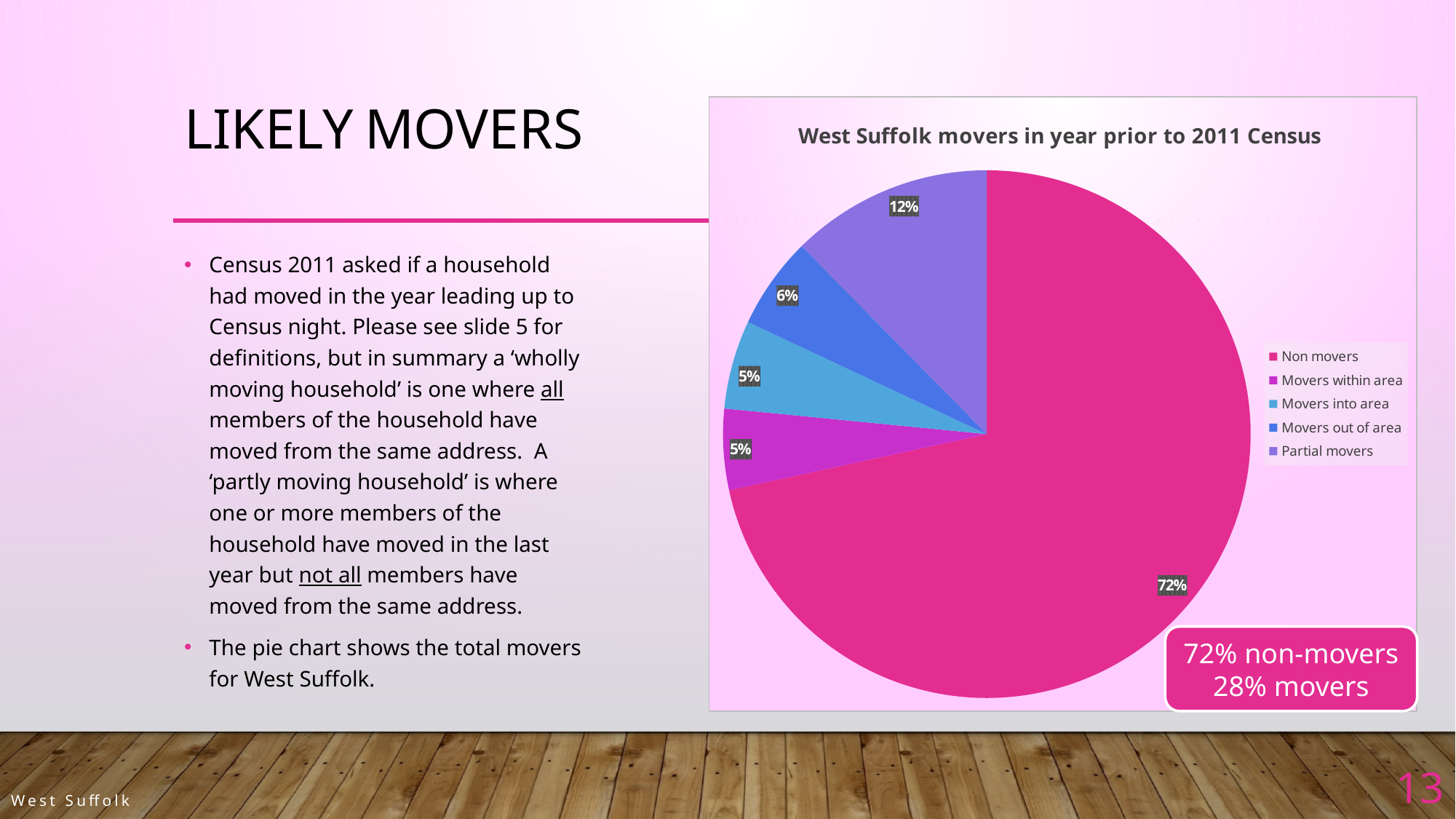
Which is larger, Partial movers or Movers out of area? Partial movers What percentage of the pie is Movers into area? 5% What is the title of the chart? West Suffolk movers in year prior to 2011 Census What percentage of the pie is Partial movers? 12% What percentage of the pie is Movers out of area? 6% What is the difference in percentage points between Non movers and Partial movers? 60 Which category has the largest slice of the pie? Non movers What percentage of the pie is Non movers? 72% What colour is the Non movers slice? Pink What type of chart is shown on the slide? Pie chart What is the difference in percentage points between Movers out of area and Movers within area? 1 How many categories does the legend list? 5